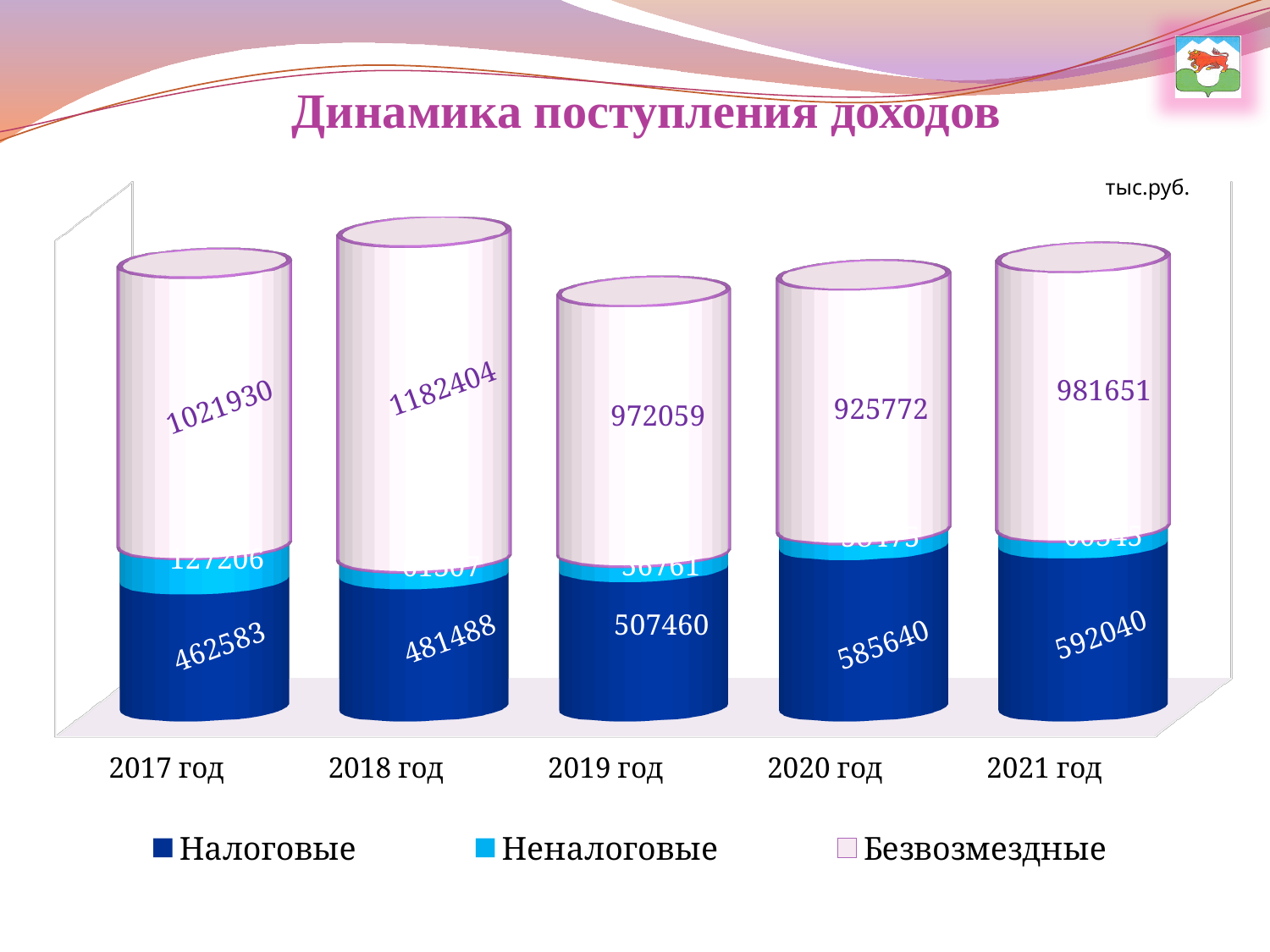
How many years are shown along the x axis? 5 In which year is the Налоговые value highest? 2021 год What is the difference between the Налоговые values for 2021 год and 2020 год? 6400 How many series does the legend list? 3 Do the Налоговые values rise or fall from 2017 год to 2021 год? Rise What kind of chart is shown on the slide? Stacked bar chart What is the value of Налоговые for 2017 год? 462583 What is the value of Налоговые for 2019 год? 507460 What is the value of Безвозмездные for 2018 год? 1182404 In which year is the Безвозмездные value highest? 2018 год Which is larger: the Безвозмездные value for 2019 год or for 2021 год? 2021 год In which year is the Безвозмездные value lowest? 2020 год